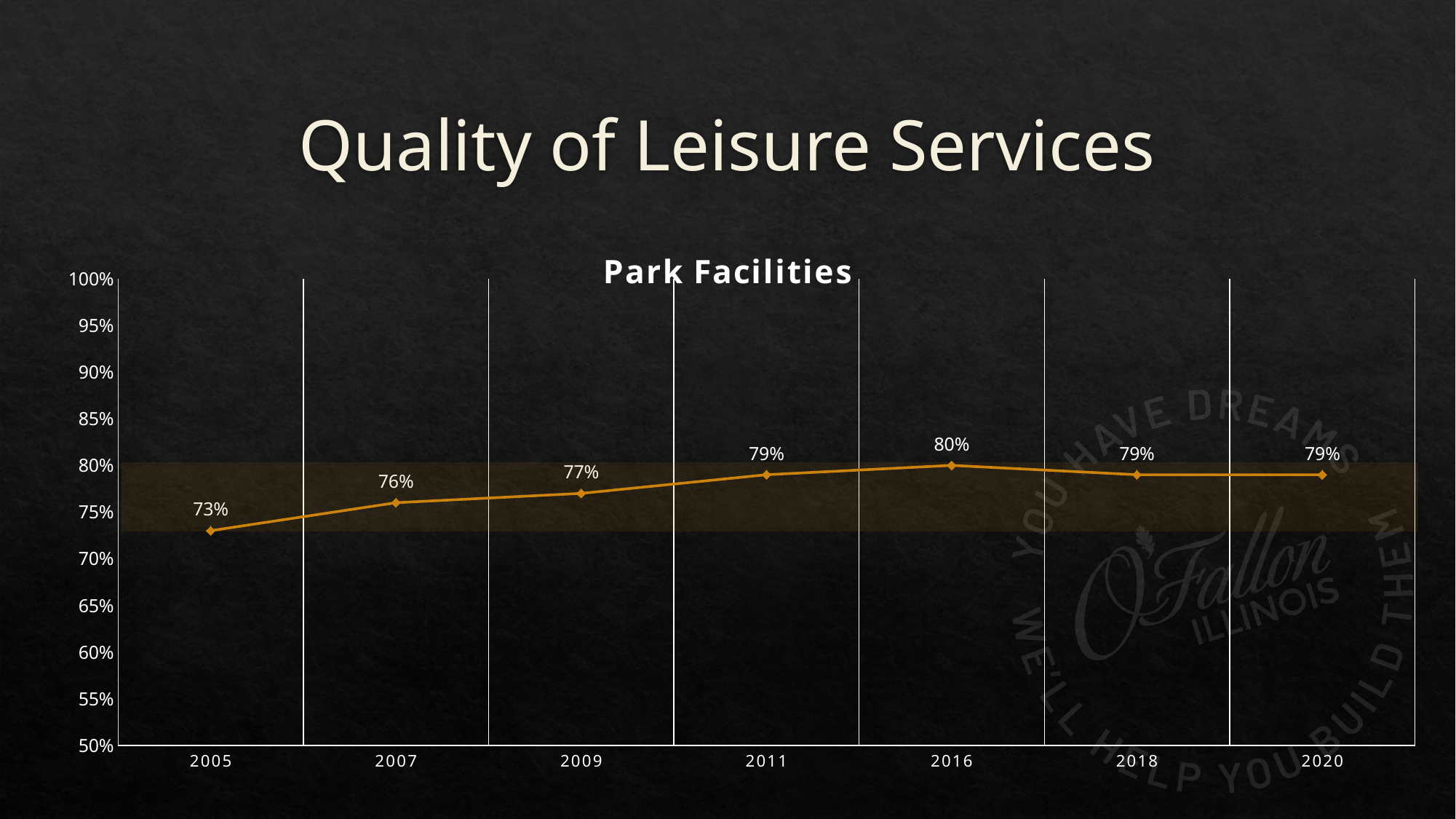
What is the title of the chart? Park Facilities What is the difference between the Park Facilities values for 2009 and 2007? 1% Which is larger, the Park Facilities value for 2007 or for 2011? 2011 Which year has the highest Park Facilities value? 2016 What is the Park Facilities value for 2016? 80% Which year has the lowest Park Facilities value? 2005 What is the Park Facilities value for 2020? 79% Do the Park Facilities values rise or fall from 2005 to 2011? Rise What is the difference between the Park Facilities values for 2016 and 2005? 7% What kind of chart is shown on the slide? Line chart How many years are plotted on the Park Facilities chart? 7 What is the Park Facilities value for 2005? 73%